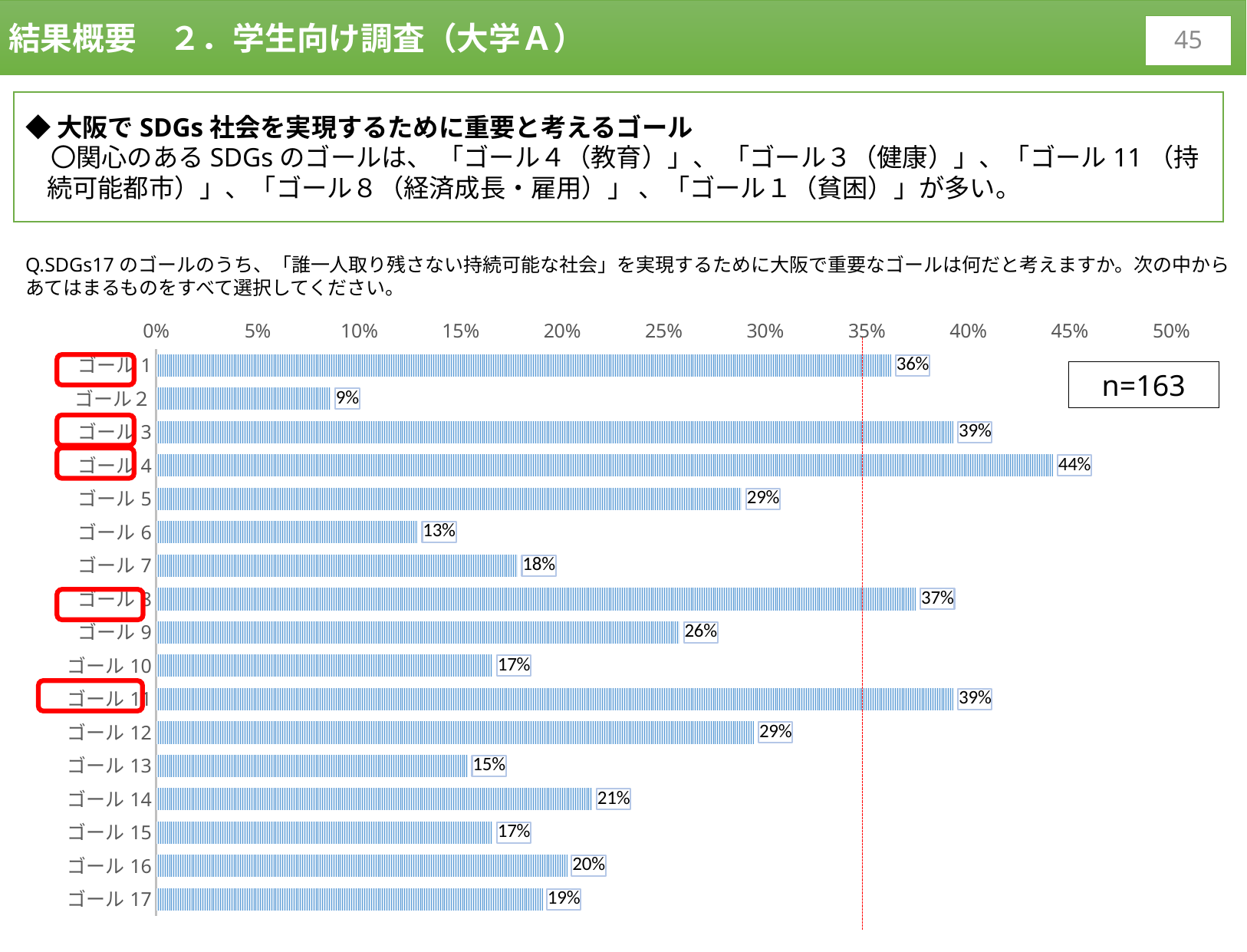
What is the value for ゴール 11? 39% What is the value for ゴール 4? 44% Is the value for ゴール 3 greater or less than 35%? greater How many categories are shown in the chart? 17 Which is larger, the value for ゴール 8 or the value for ゴール 5? ゴール 8 What kind of chart is shown on the slide? bar chart Which category has the lowest value? ゴール 2 What is the difference between the values for ゴール 4 and ゴール 1? 8% What is the value for ゴール 2? 9% Which category has the highest value? ゴール 4 What is the value for ゴール 9? 26% What sample size (n) is shown on the chart? n=163